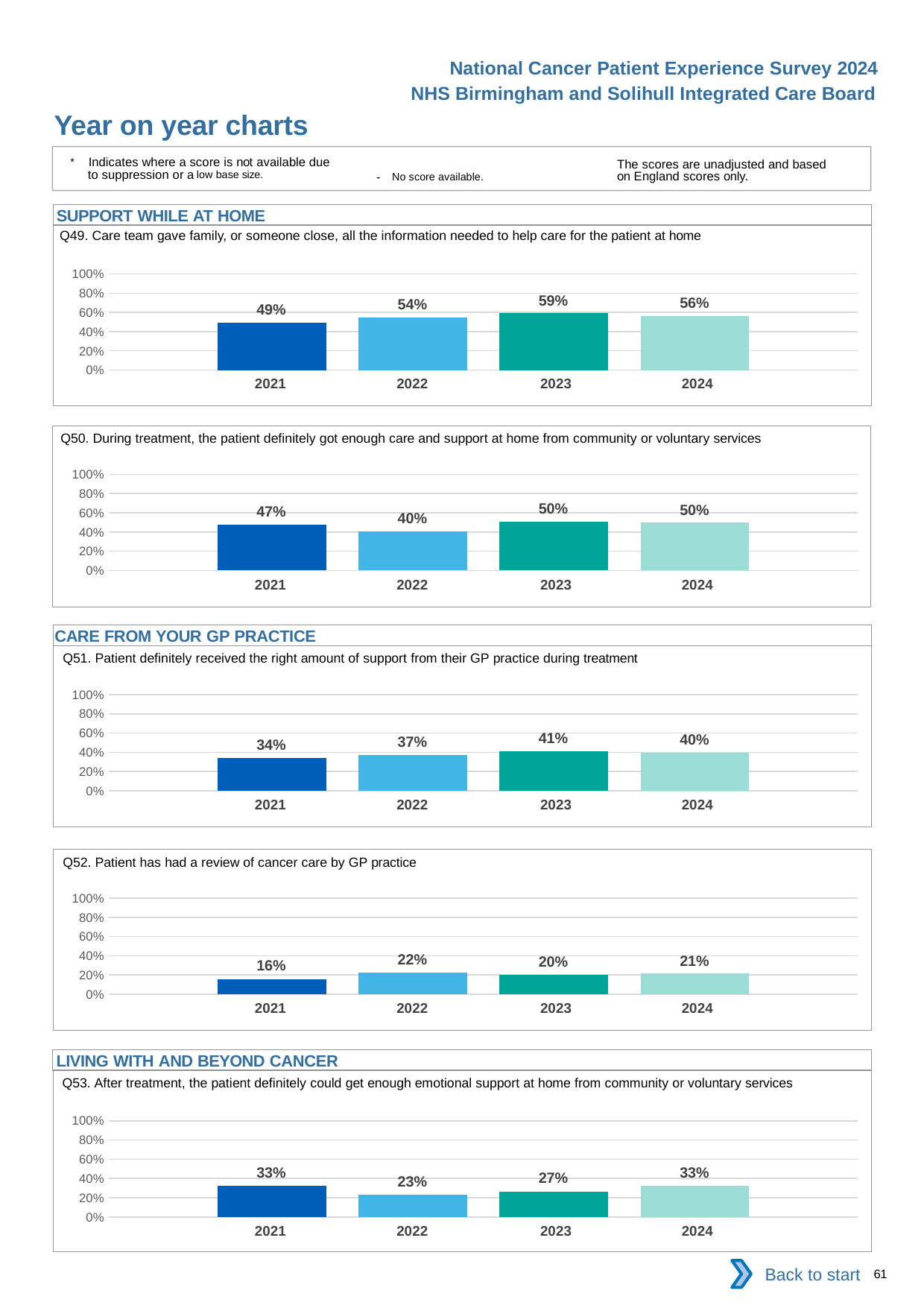
In the Q52 chart, what is the value for 2024? 21% In the Q50 chart, what is the difference between the 2023 value and the 2022 value? 10% In the Q52 chart, is the value for 2021 larger or smaller than the value for 2022? smaller In the Q53 chart, how many years are plotted? 4 In the Q51 chart, which year has the highest value? 2023 In the Q51 chart, what is the value for 2021? 34% In the Q50 chart, what is the value for 2022? 40% What kind of chart is the Q49 chart? bar chart In the Q51 chart, do the values rise or fall from 2021 to 2023? rise In the Q49 chart, which year has the lowest value? 2021 In the Q53 chart, what is the difference between the 2021 value and the 2022 value? 10% In the Q49 chart, what is the value for 2023? 59%